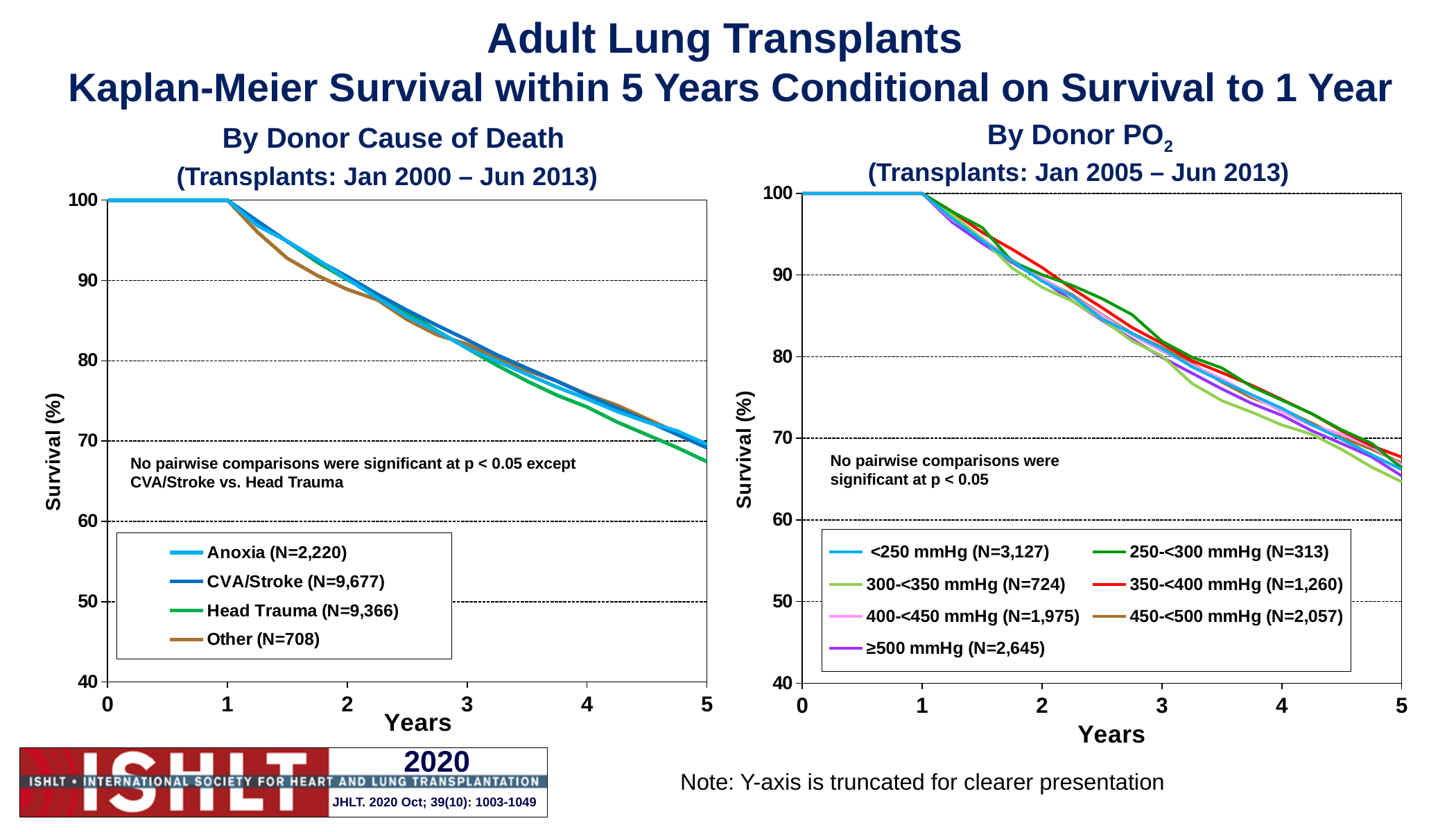
In the left chart, 'By Donor Cause of Death', is the survival for Head Trauma at year 5 greater or less than 70? less What kind of chart is the left chart, 'By Donor Cause of Death'? line chart In the left chart, 'By Donor Cause of Death', do the survival curves rise or fall from year 1 to year 5? fall In the right chart, 'By Donor PO2', is the survival for 250-<300 mmHg at year 4 greater or less than 80? less How many series does the legend of the left chart, 'By Donor Cause of Death', list? 4 How many series does the legend of the right chart, 'By Donor PO2', list? 7 In the left chart, 'By Donor Cause of Death', is the survival for Other at year 2 greater or less than 90? less In the left chart, 'By Donor Cause of Death', what is the N shown in the legend for CVA/Stroke? 9,677 In the right chart, 'By Donor PO2', what is the N shown in the legend for <250 mmHg? 3,127 In the left chart, 'By Donor Cause of Death', what is the survival (%) for all groups at year 1? 100 In the right chart, 'By Donor PO2', what is the survival (%) for all groups at year 0? 100